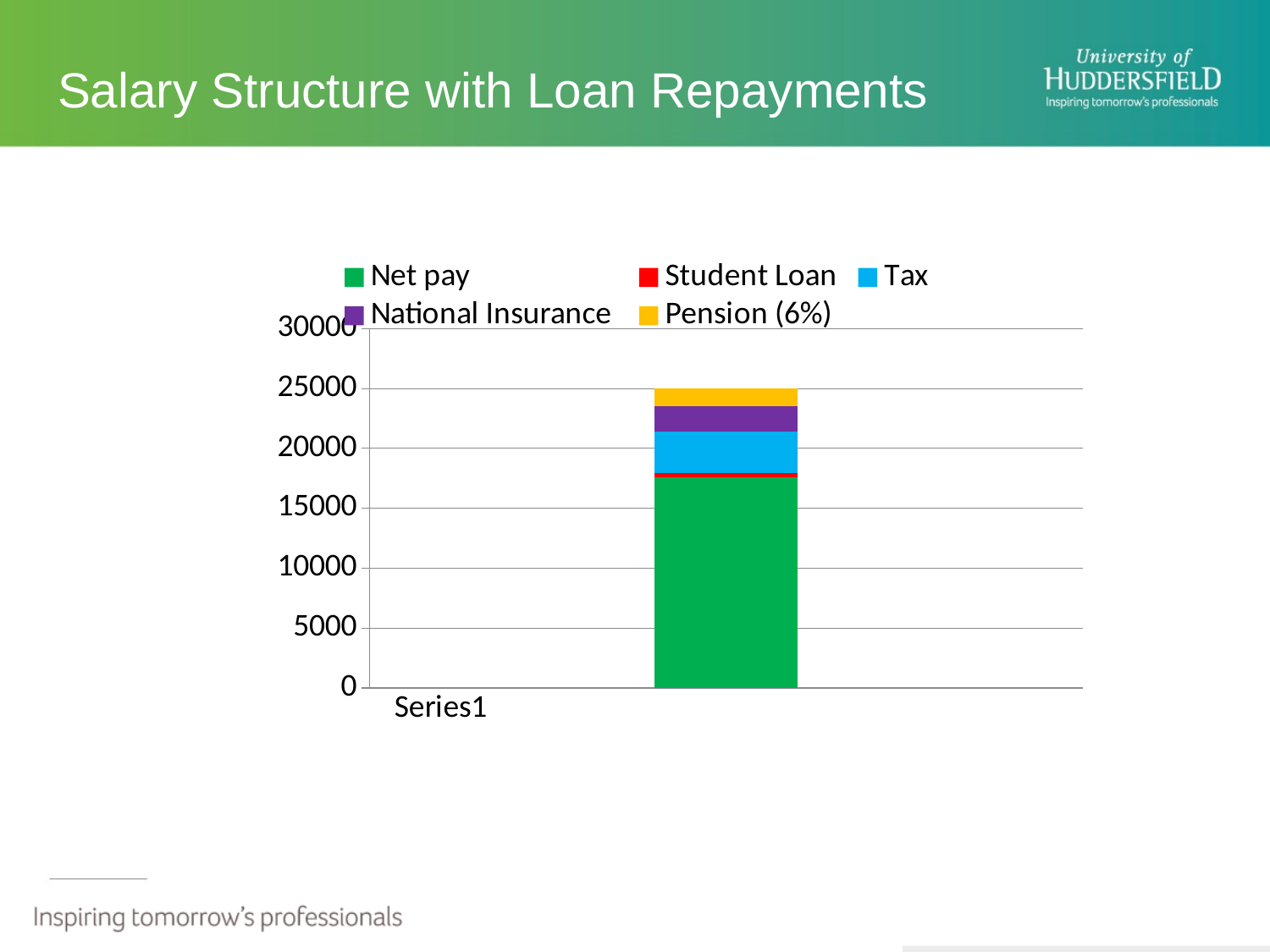
How many categories are plotted on the x axis? 1 Which series makes up the smallest segment of the stacked bar? Student Loan Which is larger, the Net pay segment or the National Insurance segment? Net pay Which is larger, the Tax segment or the Student Loan segment? Tax What is the total height of the stacked bar for Series1? 25000 What colour represents Pension (6%) in the legend? Yellow What kind of chart is shown on the slide? Stacked bar chart Is the value for Tax greater or less than 5000? less Which series makes up the largest segment of the stacked bar? Net pay What is the label of the single category on the x axis? Series1 How many series does the legend list? 5 Is the value for Net pay greater or less than 15000? greater